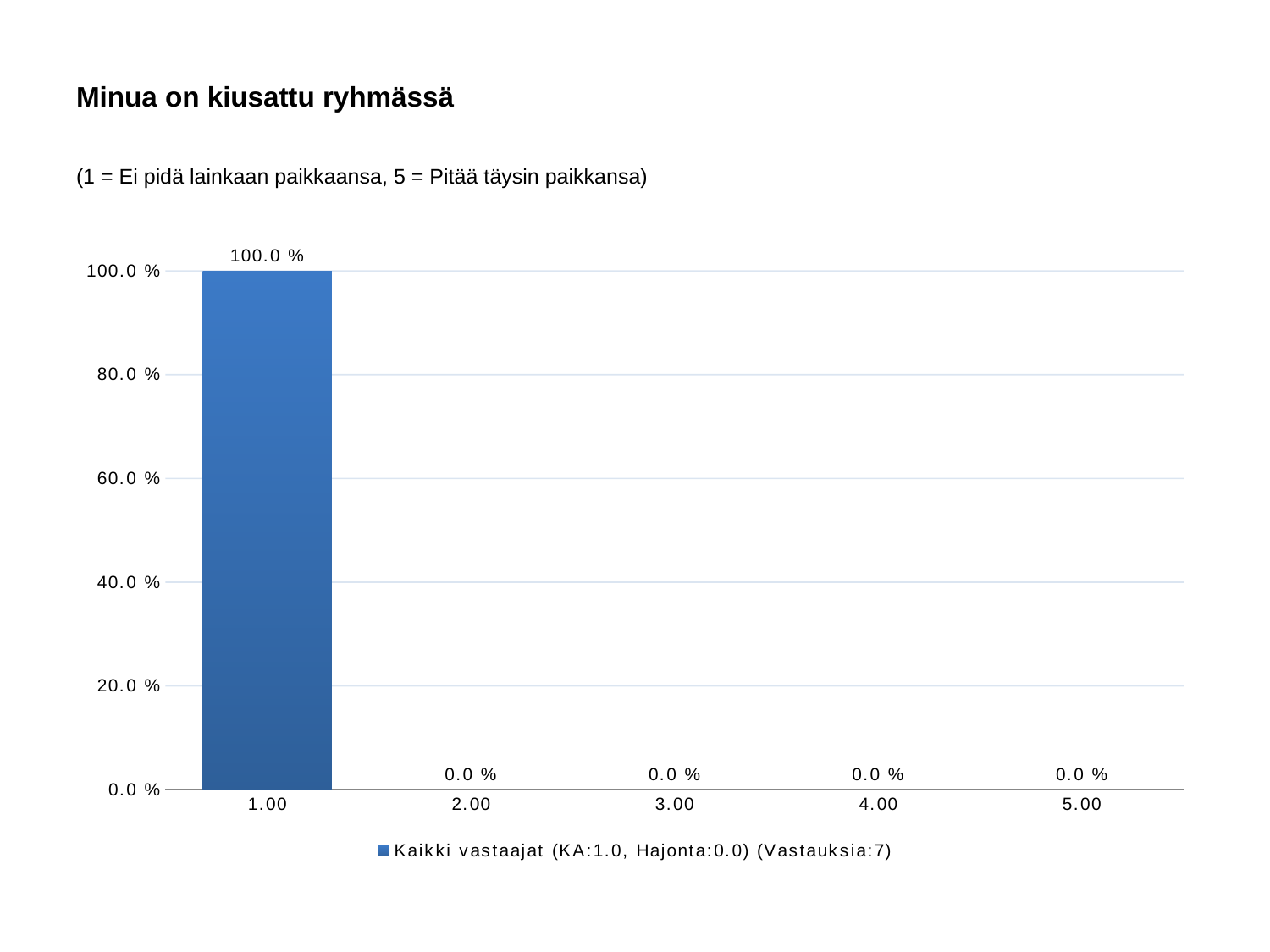
What is the value for category 3.00? 0.0 % What is the title of the chart? Minua on kiusattu ryhmässä What kind of chart is shown? bar chart What is the difference between the values for 1.00 and 2.00? 100.0 % How many series does the legend list? 1 Which is larger, the value for 1.00 or the value for 4.00? 1.00 Is the value for 1.00 greater or less than 80.0 %? greater What is the value for category 1.00? 100.0 % What is the value for category 5.00? 0.0 % Which category has the highest value? 1.00 How many categories are shown on the x axis? 5 Do the values rise or fall from category 1.00 to category 2.00? fall